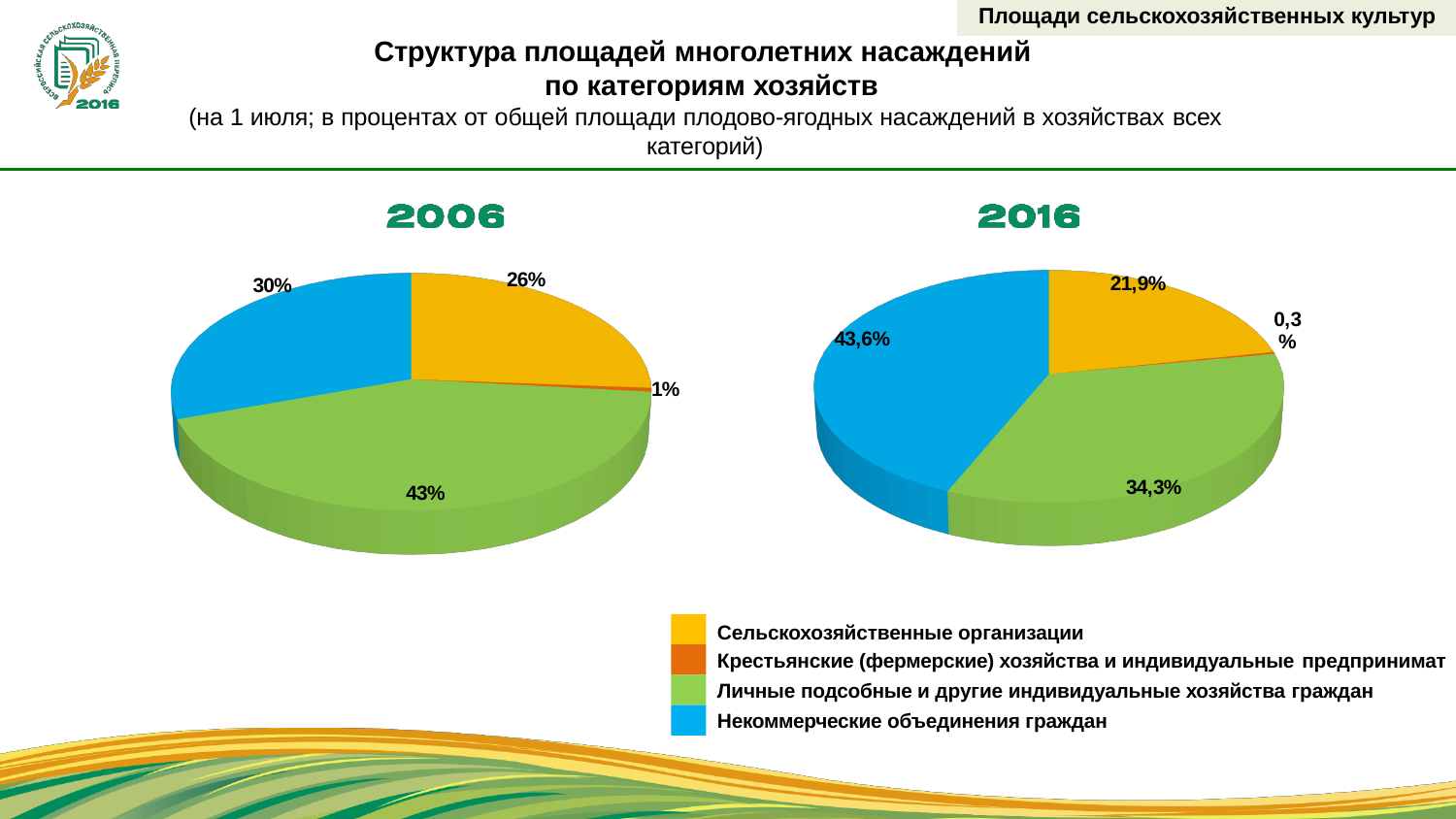
На диаграмме «2016» какая доля приходится на некоммерческие объединения граждан? 43,6% На диаграмме «2006» какая категория хозяйств имеет наименьшую долю? Крестьянские (фермерские) хозяйства и индивидуальные предприниматели На диаграмме «2016» какая доля приходится на сельскохозяйственные организации? 21,9% На диаграмме «2006» какая категория хозяйств имеет наибольшую долю? Личные подсобные и другие индивидуальные хозяйства граждан Сколько категорий хозяйств показано на каждой круговой диаграмме? 4 На диаграмме «2006» на сколько процентных пунктов доля личных подсобных хозяйств больше доли сельскохозяйственных организаций? 17 На диаграмме «2006» какая доля приходится на личные подсобные и другие индивидуальные хозяйства граждан? 43% Какая доля больше: сельскохозяйственных организаций на диаграмме «2006» или на диаграмме «2016»? 2006 Какого типа диаграммы представлены на слайде? Круговые диаграммы На диаграмме «2006» какая доля приходится на крестьянские (фермерские) хозяйства и индивидуальных предпринимателей? 1% На диаграмме «2016» какая категория хозяйств имеет наибольшую долю? Некоммерческие объединения граждан На диаграмме «2016» на сколько процентных пунктов доля некоммерческих объединений граждан больше доли личных подсобных и других индивидуальных хозяйств граждан? 9,3